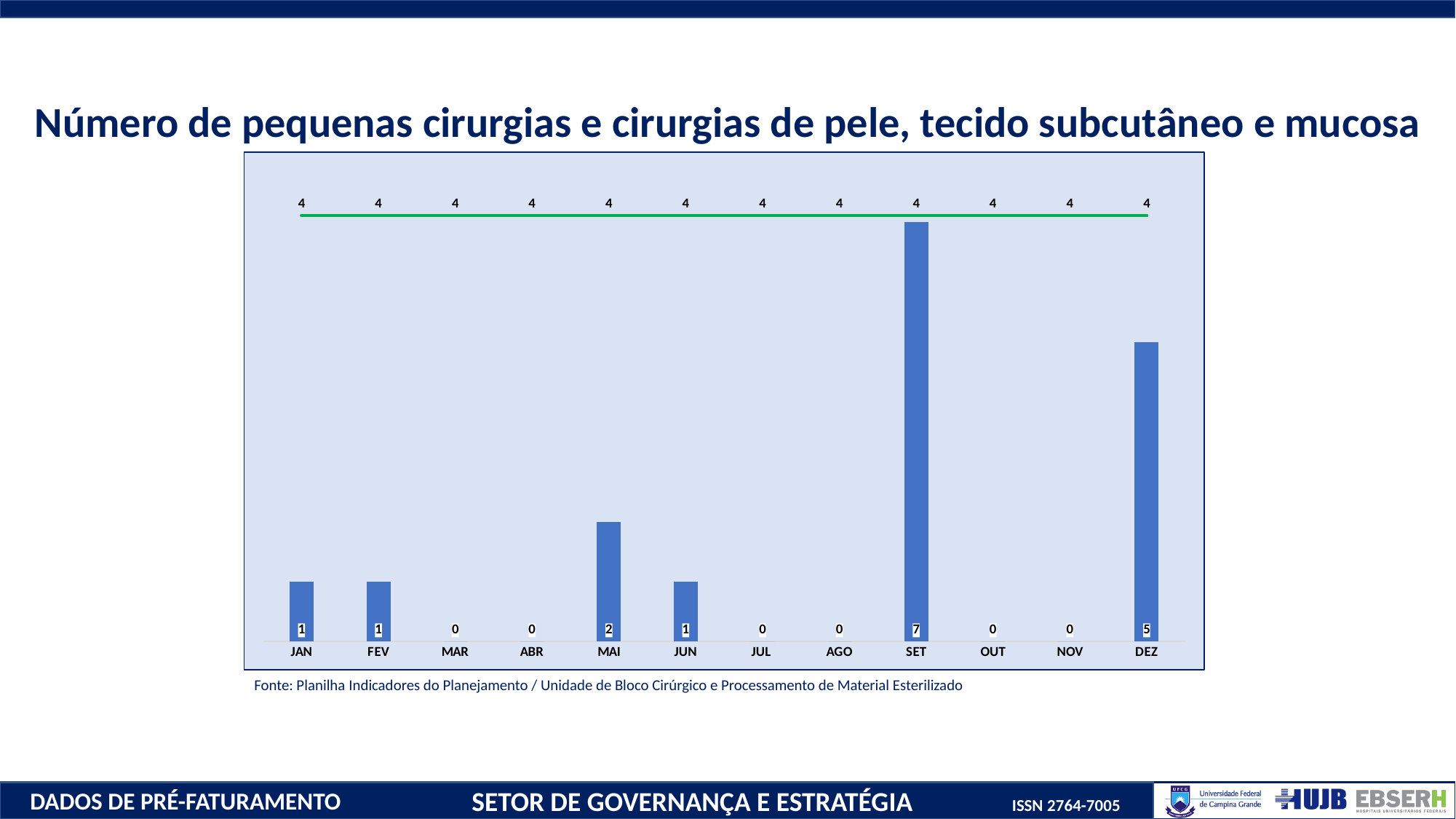
Which is larger, the value for MAI or the value for JUN? MAI How many months are shown on the x axis? 12 What is the value for MAI? 2 What is the difference between the values for SET and DEZ? 2 What colour is the horizontal line marking the value 4? Green What kind of chart is this? Bar and line chart How many months have a value of 0? 6 What is the value of the green line for JAN? 4 Which month has the highest bar value? SET What is the value for SET? 7 What is the title of the chart? Número de pequenas cirurgias e cirurgias de pele, tecido subcutâneo e mucosa What is the value for DEZ? 5